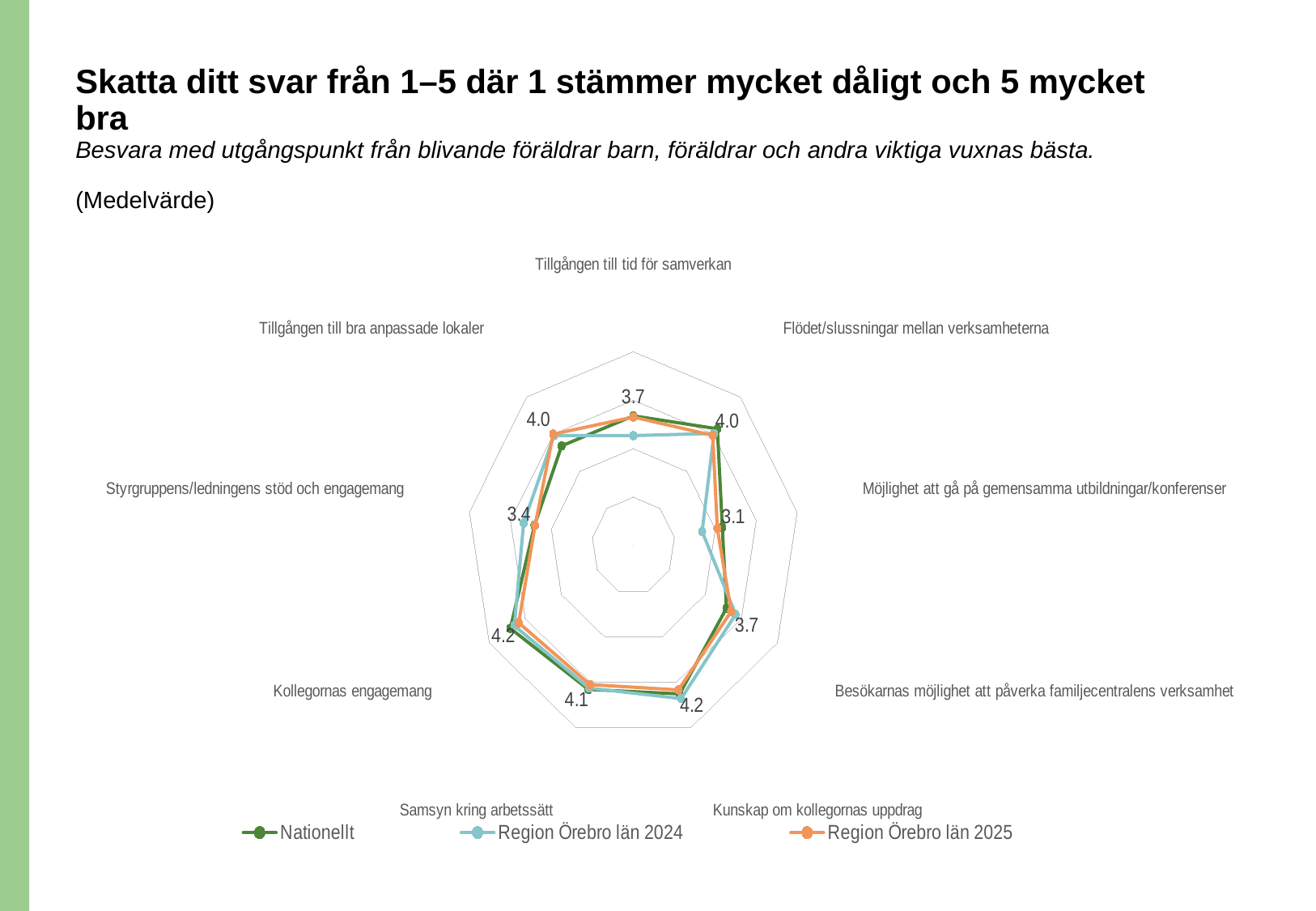
According to the data labels, what is the value for 'Samsyn kring arbetssätt'? 4.1 According to the data labels, what is the value for 'Möjlighet att gå på gemensamma utbildningar/konferenser'? 3.1 Which has the larger labelled value: 'Flödet/slussningar mellan verksamheterna' or 'Styrgruppens/ledningens stöd och engagemang'? Flödet/slussningar mellan verksamheterna How many categories (axes) does the radar chart have? 9 Which series is drawn in orange in the legend? Region Örebro län 2025 What is the difference between the labelled values for 'Kollegornas engagemang' and 'Möjlighet att gå på gemensamma utbildningar/konferenser'? 1.1 How many series does the legend list? 3 What statistic does the slide say the chart shows, as given in parentheses under the subtitle? Medelvärde According to the data labels, what is the value for 'Styrgruppens/ledningens stöd och engagemang'? 3.4 What kind of chart is shown on the slide? Radar chart Which category has the lowest labelled value? Möjlighet att gå på gemensamma utbildningar/konferenser According to the data labels, what is the value for 'Tillgången till tid för samverkan'? 3.7